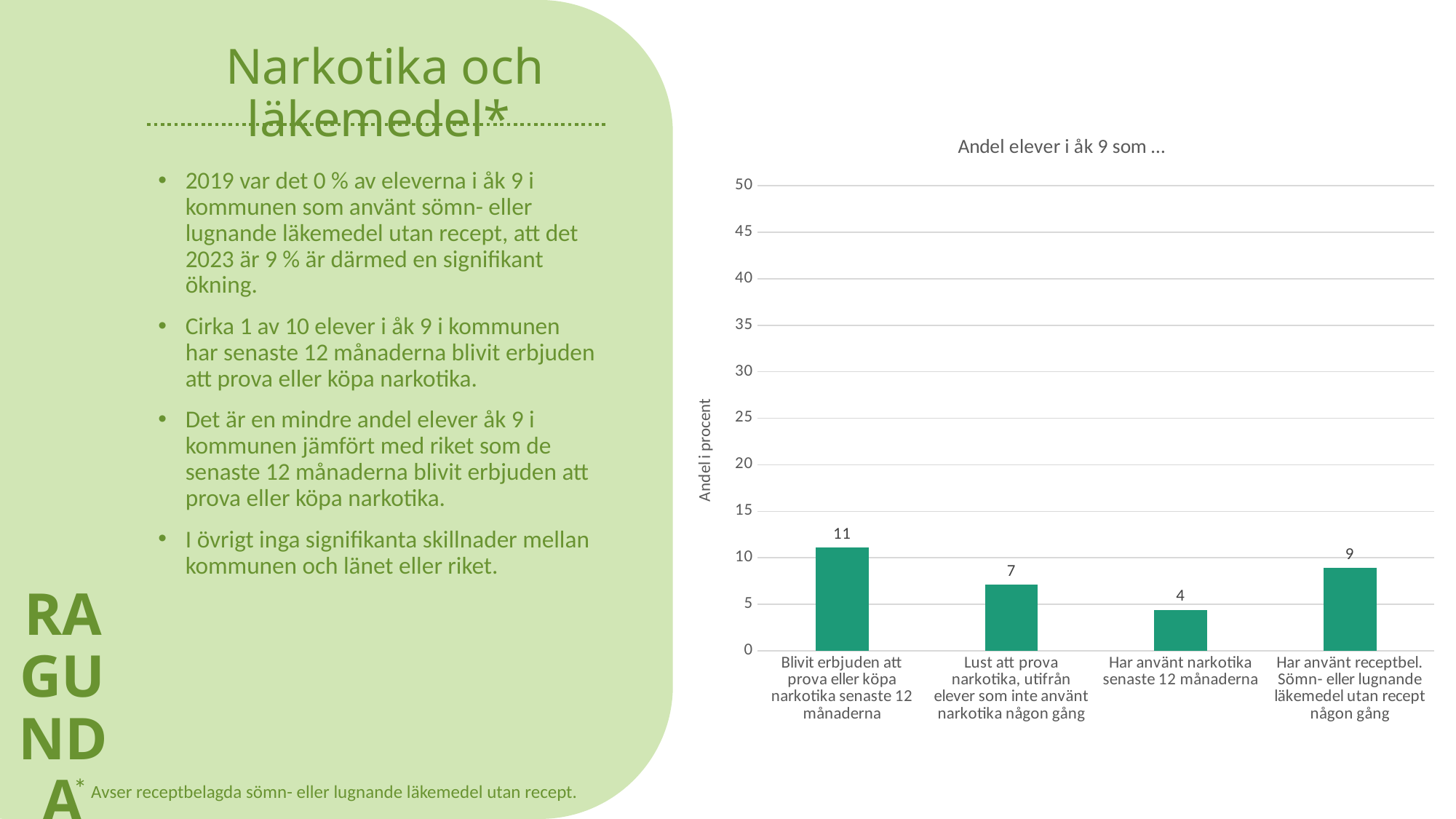
Which category has the highest value? Blivit erbjuden att prova eller köpa narkotika senaste 12 månaderna Which category has the lowest value? Har använt narkotika senaste 12 månaderna Is the value for 'Blivit erbjuden att prova eller köpa narkotika senaste 12 månaderna' greater or less than 10? greater What is the value for 'Har använt narkotika senaste 12 månaderna'? 4 How many categories are shown in the chart? 4 What is the value for 'Blivit erbjuden att prova eller köpa narkotika senaste 12 månaderna'? 11 Which is larger: the value for 'Lust att prova narkotika' or the value for 'Har använt receptbel. Sömn- eller lugnande läkemedel utan recept någon gång'? Har använt receptbel. Sömn- eller lugnande läkemedel utan recept någon gång What is the difference between the values for 'Blivit erbjuden att prova eller köpa narkotika senaste 12 månaderna' and 'Har använt narkotika senaste 12 månaderna'? 7 What is the title of the chart? Andel elever i åk 9 som … What is the value for 'Lust att prova narkotika, utifrån elever som inte använt narkotika någon gång'? 7 What is the value for 'Har använt receptbel. Sömn- eller lugnande läkemedel utan recept någon gång'? 9 What kind of chart is shown on the slide? bar chart